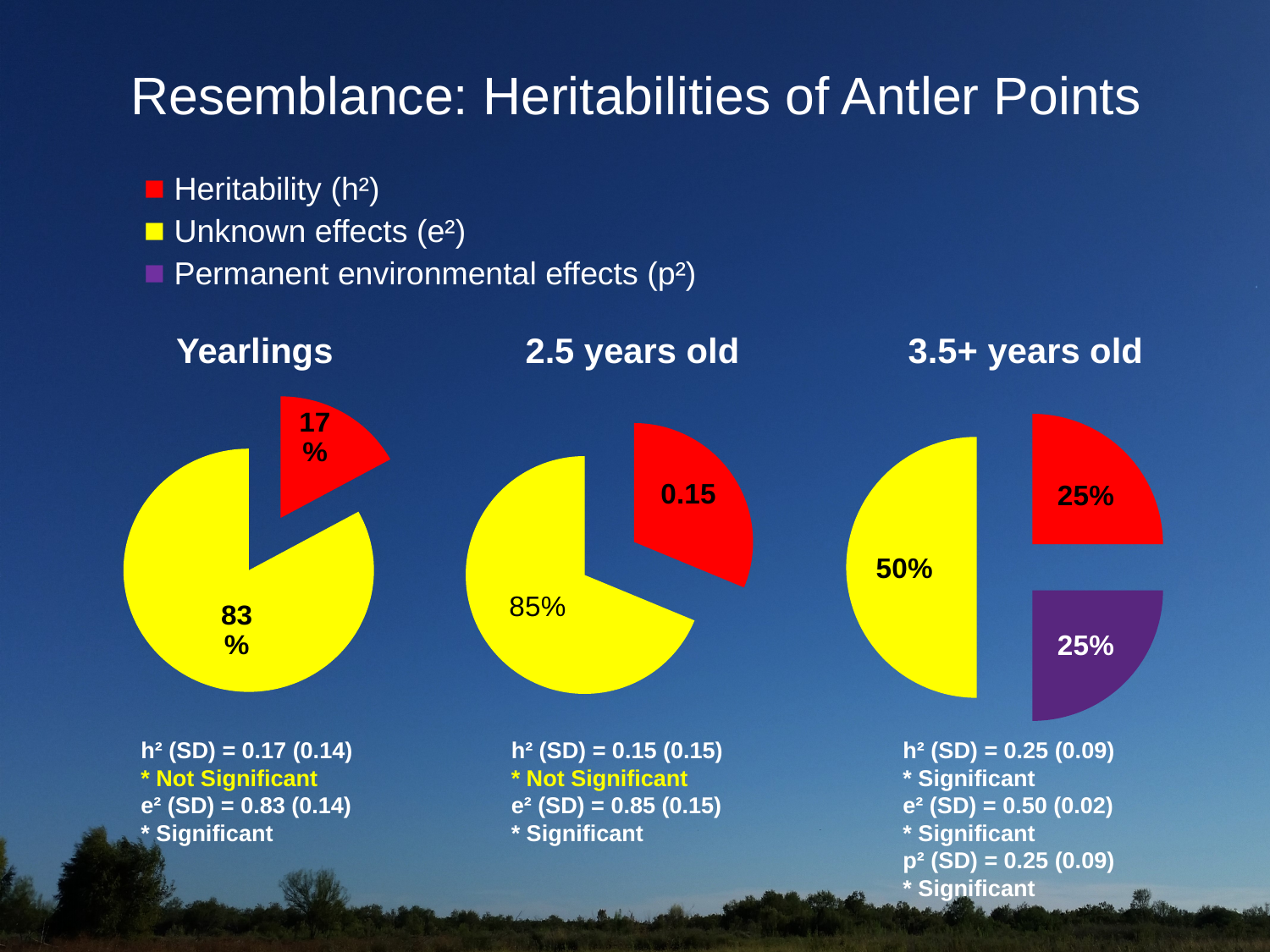
In the 3.5+ years old pie chart, which slice is the largest? Unknown effects (e²) In the Yearlings pie chart, what share is labelled for the Unknown effects (e²) slice? 83% In the Yearlings pie chart, what share is labelled for the Heritability (h²) slice? 17% In the Yearlings pie chart, what is the difference between the Unknown effects share and the Heritability share? 66% How many entries does the legend at the top of the slide list? 3 What type of chart is used for the Yearlings, 2.5 years old and 3.5+ years old groups? Pie chart In the 2.5 years old pie chart, what share is labelled for the Unknown effects (e²) slice? 85% In the 3.5+ years old pie chart, what share is labelled for the Permanent environmental effects (p²) slice? 25% In the Yearlings pie chart, which slice is the largest? Unknown effects (e²) How many slices does the 3.5+ years old pie chart have? 3 In the 2.5 years old pie chart, what value is printed on the red Heritability slice? 0.15 In the 3.5+ years old pie chart, what share is labelled for the Unknown effects (e²) slice? 50%